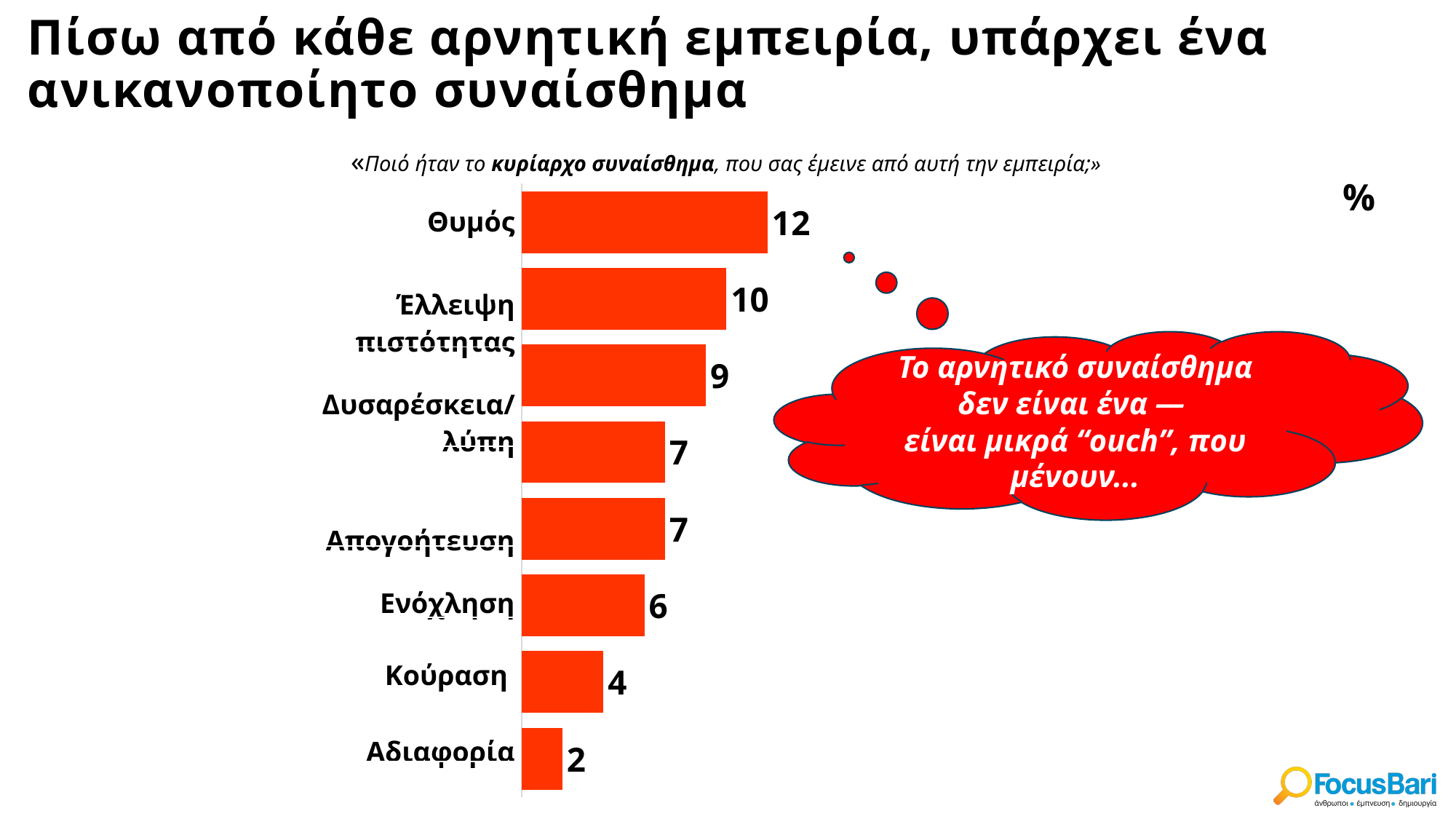
Which category has the highest value? Θυμός What is the difference between the values for Θυμός and Έλλειψη πιστότητας? 2 What value is shown for Απογοήτευση? 7 What value is shown for Αδιαφορία? 2 What kind of chart is shown on the slide? Bar chart Which is larger, the value for Ενόχληση or the value for Κούραση? Ενόχληση What value is shown for Θυμός? 12 What value is shown for Ενόχληση? 6 How many bars are plotted in the chart? 8 What value is shown for Κούραση? 4 Which category has the lowest value? Αδιαφορία What value is shown for Έλλειψη πιστότητας? 10